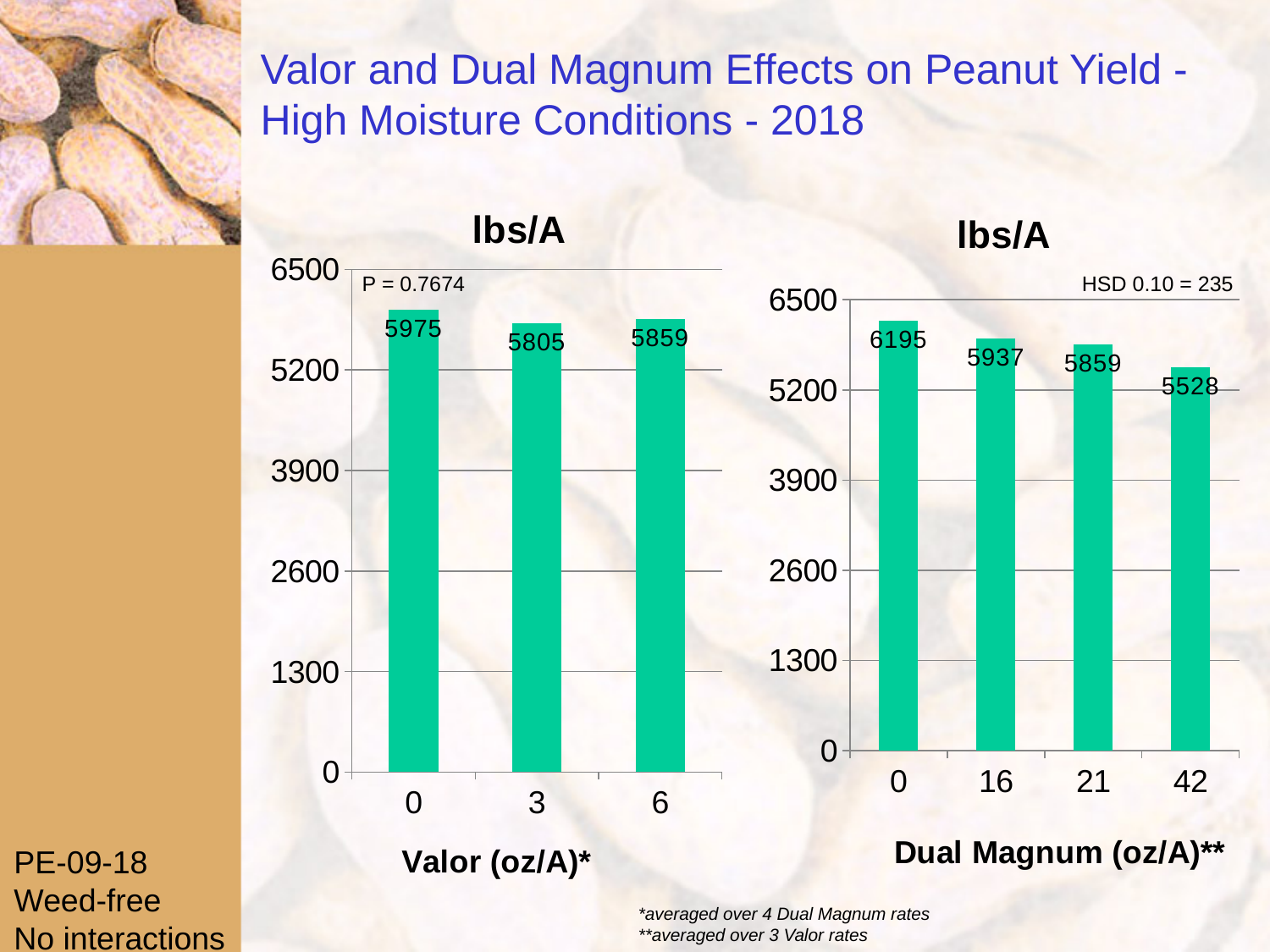
In the right chart (Dual Magnum (oz/A)), do yields rise or fall as the rate increases from 0 to 42? Fall In the right chart (Dual Magnum (oz/A)), which rate has the highest yield? 0 In the right chart (Dual Magnum (oz/A)), which rate has the lowest yield? 42 How many Dual Magnum rates are shown in the right chart? 4 In the left chart (Valor (oz/A)), which rate has the lowest yield? 3 In the right chart (Dual Magnum (oz/A)), what is the yield in lbs/A at the 42 oz/A rate? 5528 In the right chart (Dual Magnum (oz/A)), what is the yield in lbs/A at the 16 oz/A rate? 5937 What type of chart is the left chart (Valor (oz/A))? Bar chart In the left chart (Valor (oz/A)), what is the yield in lbs/A at the 0 oz/A rate? 5975 In the left chart (Valor (oz/A)), what is the difference in yield between the 0 and 3 oz/A rates? 170 In the left chart (Valor (oz/A)), what is the yield in lbs/A at the 3 oz/A rate? 5805 In the right chart (Dual Magnum (oz/A)), what is the difference in yield between the 0 and 42 oz/A rates? 667